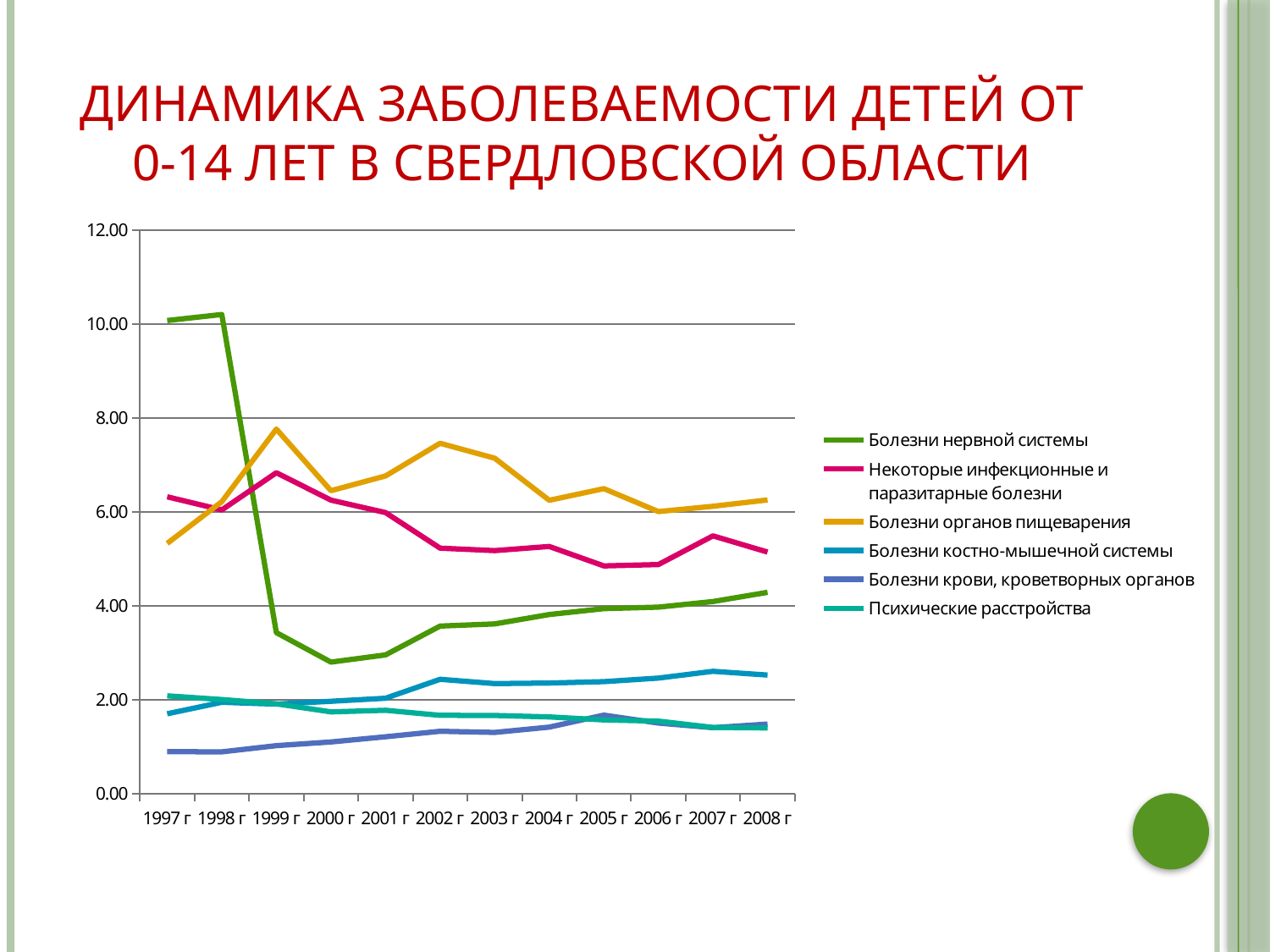
In which year does Болезни нервной системы reach its lowest value? 2000 г How many years are shown along the x axis? 12 In 2002 г, which is larger: Болезни органов пищеварения or Некоторые инфекционные и паразитарные болезни? Болезни органов пищеварения How many series does the legend list? 6 Is the value for Болезни нервной системы in 1997 г greater or less than 8.00? greater Which series has the lowest value in 1997 г? Болезни крови, кроветворных органов Is the value for Болезни костно-мышечной системы in 2007 г greater or less than 2.00? greater What kind of chart is shown on the slide? line chart Which series has the highest value in 2008 г? Болезни органов пищеварения Does the value for Болезни нервной системы rise or fall between 1998 г and 1999 г? fall Is the value for Болезни крови, кроветворных органов in 1997 г greater or less than 2.00? less Which series has the highest value in 1997 г? Болезни нервной системы